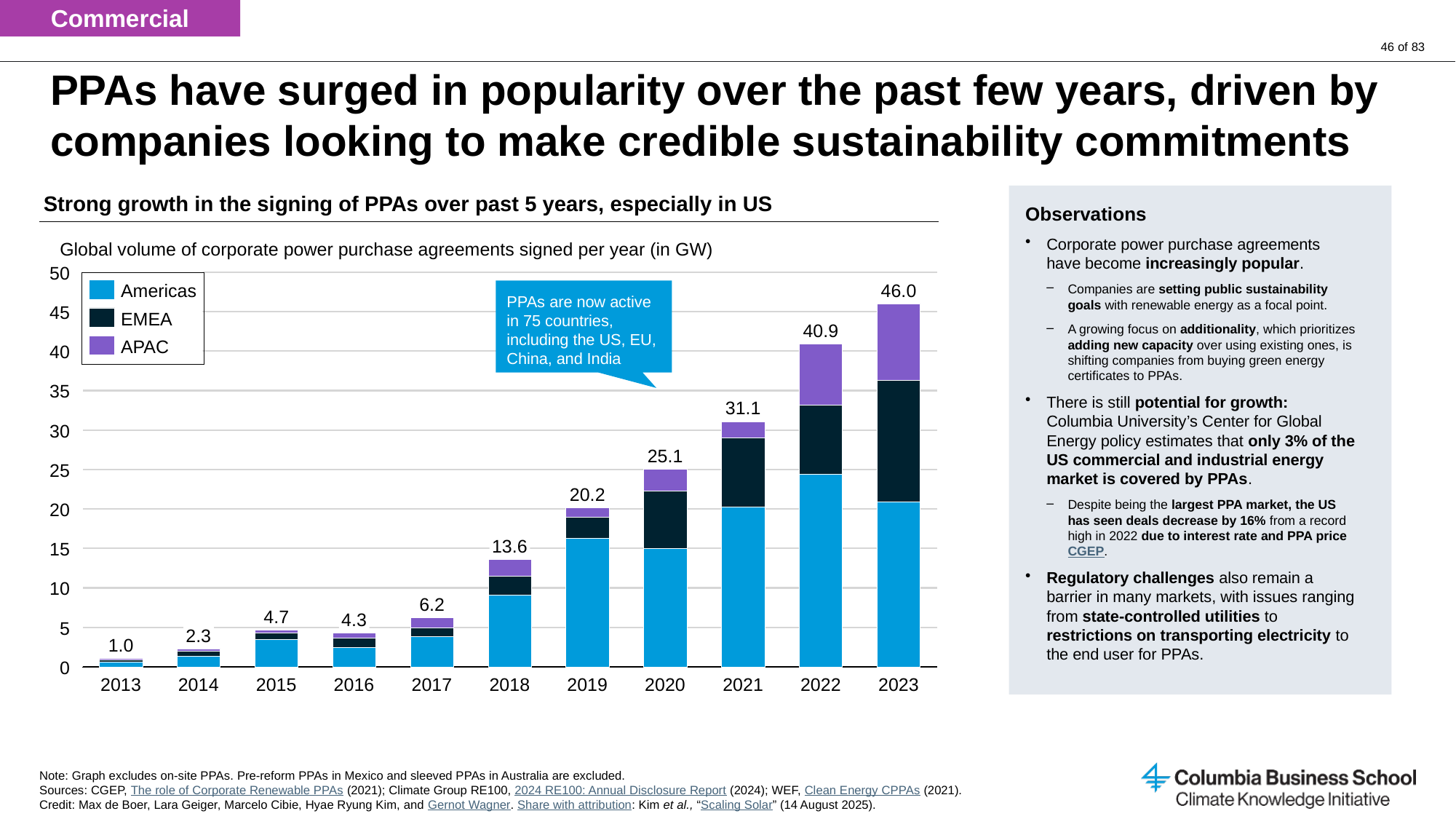
What is the total value shown for 2020? 25.1 What is the total global volume of corporate PPAs signed in 2023? 46.0 What is the total value shown for 2018? 13.6 Which year has the lowest total volume of PPAs signed? 2013 How many years are shown on the x axis of the chart? 11 Which region is shown in purple in the chart legend? APAC Which year has a larger total, 2015 or 2016? 2015 How many series does the chart legend list? 3 Which year has the highest total volume of PPAs signed? 2023 Is the Americas value for 2022 greater or less than 20? greater What type of chart is shown on the slide? Stacked bar chart What is the difference between the total for 2023 and the total for 2022? 5.1